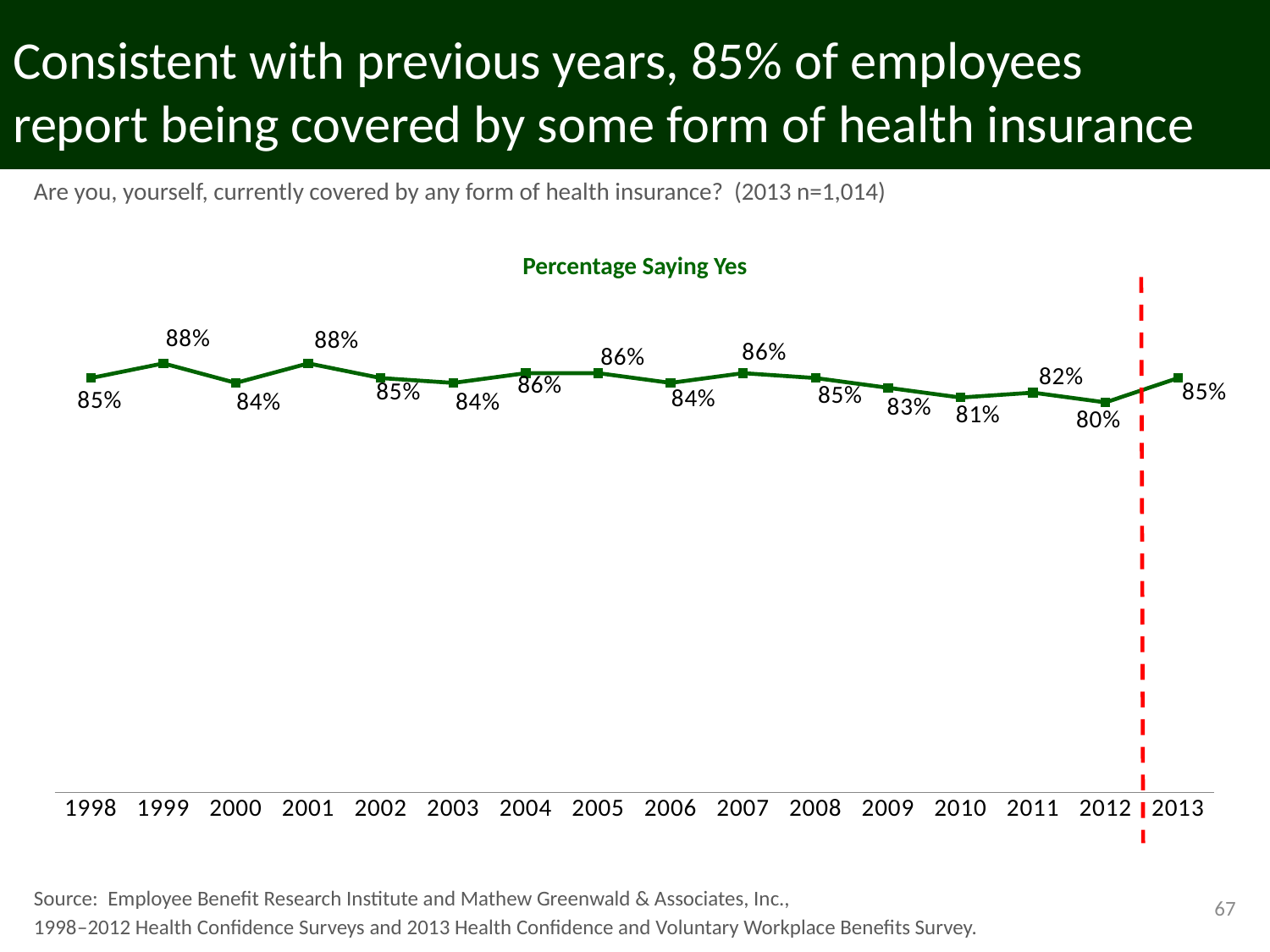
What is the title of the chart? Percentage Saying Yes What is the difference between the percentage saying yes in 2012 and in 2013? 5% What colour is the line on the chart? Green How many years are plotted on the chart? 16 Which year has the lowest percentage saying yes? 2012 Did the percentage saying yes rise or fall from 2012 to 2013? Rise What percentage of employees said yes in 2001? 88% What is the difference between the percentage saying yes in 1999 and in 2010? 7% What percentage of employees said yes in 2010? 81% What kind of chart is shown on the slide? Line chart What percentage of employees said yes in 2013? 85% Which is larger, the percentage saying yes in 2007 or in 2009? 2007